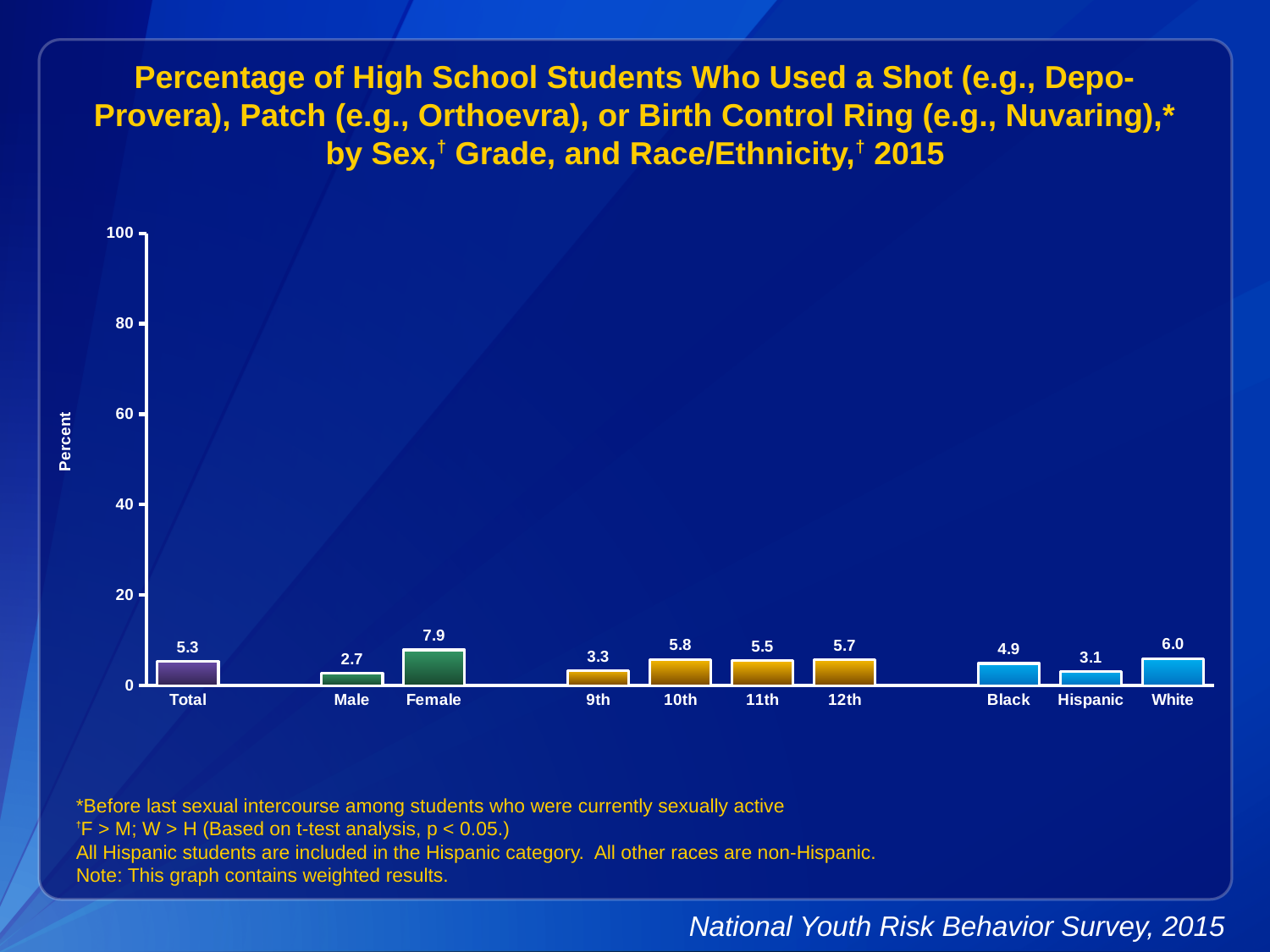
What kind of chart is this? bar chart What is the value for Total? 5.3 How many categories are shown on the x axis? 10 What is the value for Female? 7.9 What is the value for Hispanic? 3.1 Is the value for 12th greater or less than 20? less Which category has the highest value? Female Which is larger, the value for White or the value for Black? White What is the label of the y axis? Percent What is the difference between the values for Female and Male? 5.2 Which category has the lowest value? Male What is the difference between the values for 10th and 9th? 2.5